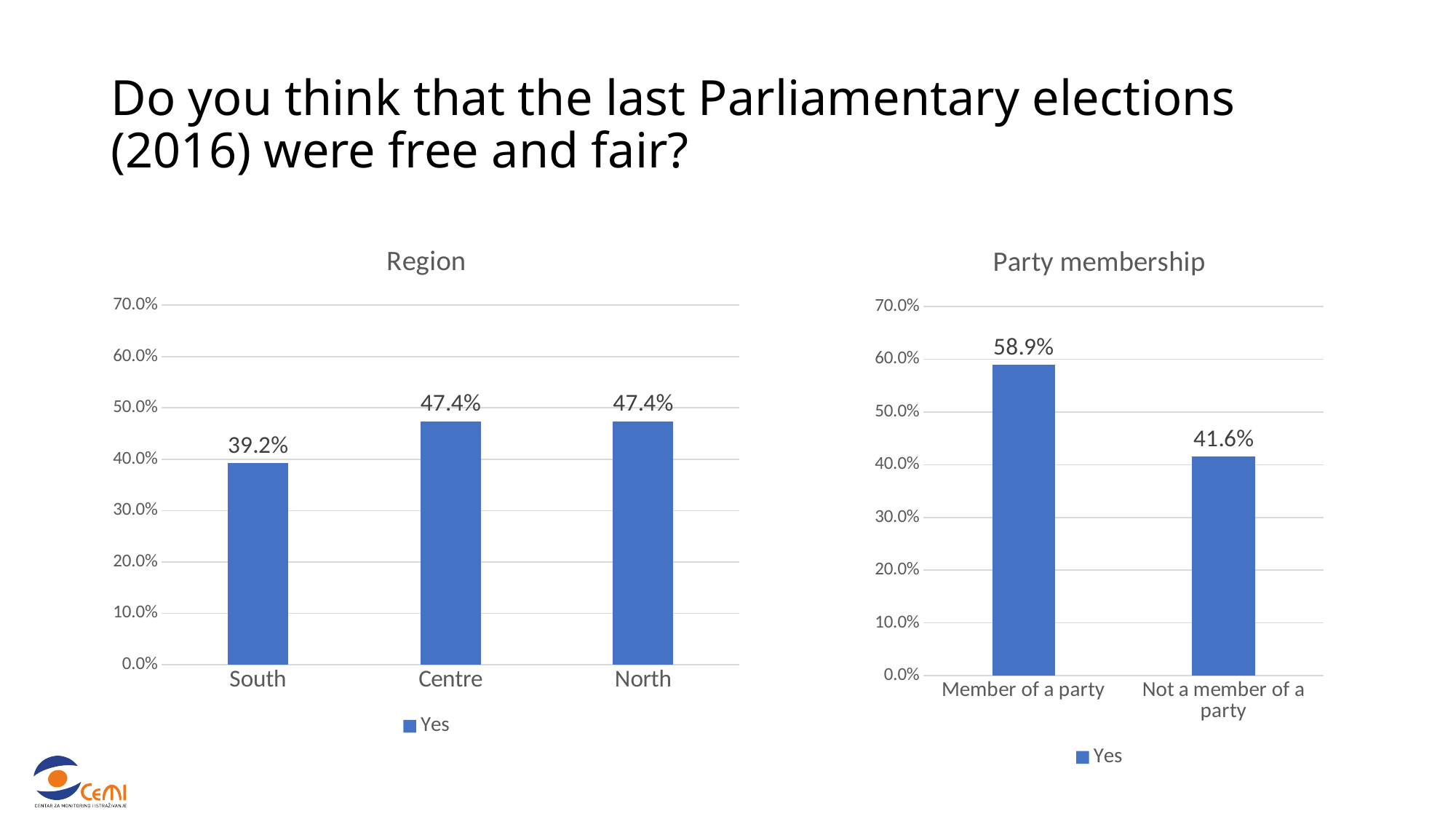
In the Party membership chart, what is the difference between Member of a party and Not a member of a party? 17.3% In the Region chart, how many regions are shown? 3 In the Party membership chart, which category has the highest value? Member of a party In the Region chart, which region has the lowest value? South In the Party membership chart, what is the value for Member of a party? 58.9% In the Party membership chart, what is the value for Not a member of a party? 41.6% In the Region chart, what is the value for South? 39.2% In the Region chart, what is the difference between the values for Centre and South? 8.2% In the Region chart, what is the value for Centre? 47.4% What kind of chart is the Party membership chart? bar chart In the Region chart, is the value for South greater or less than 40.0%? less How many series does the legend of the Region chart list? 1